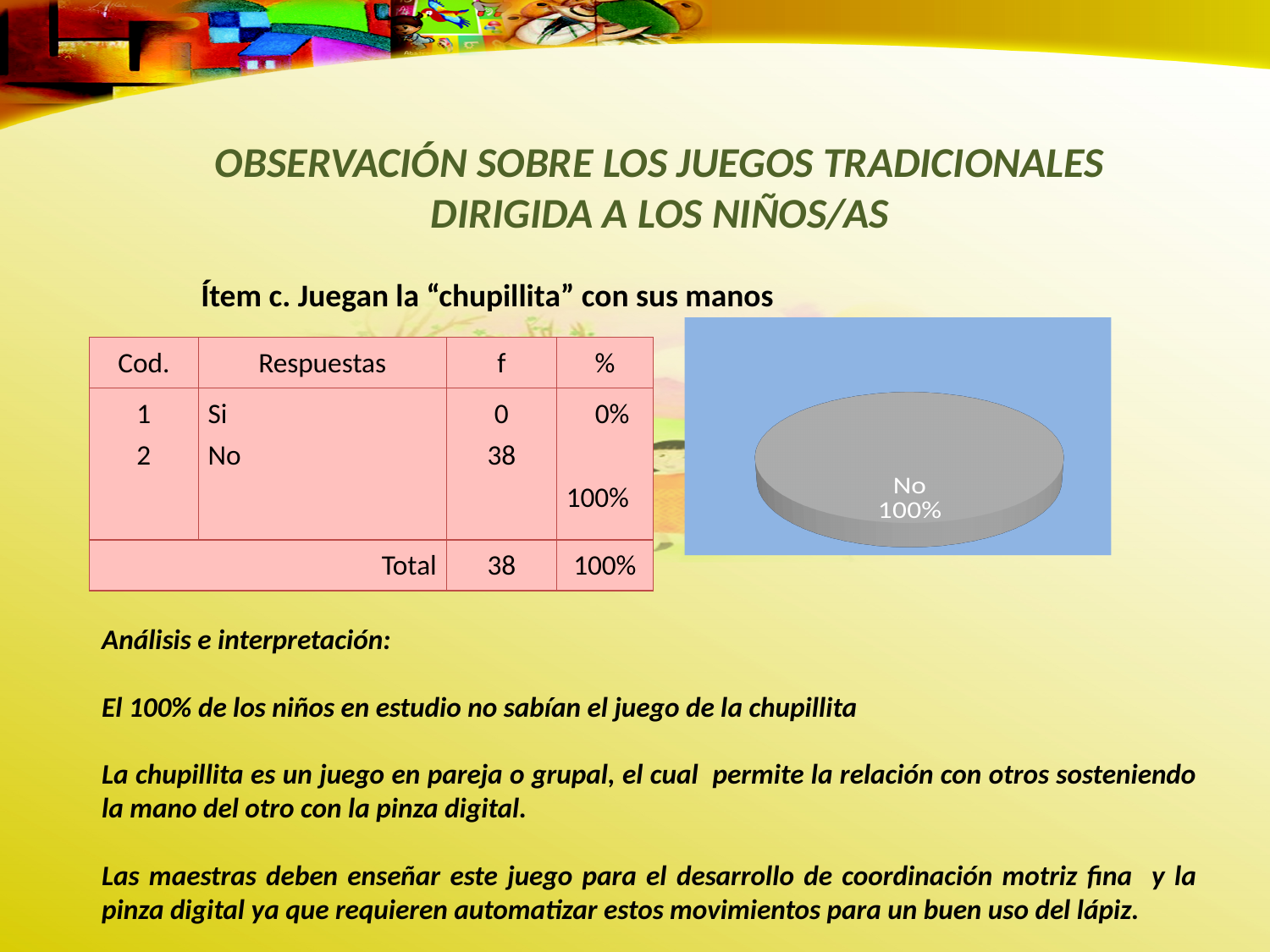
How many slices are visible in the pie chart? 1 What colour is the slice in the pie chart? grey What label is printed on the pie chart's slice? No 100% What share of the pie chart does the "No" slice represent? 100% What is the background colour of the pie chart area? blue Is the share of the "No" slice in the pie chart greater or less than 50%? greater Which category occupies the largest slice of the pie chart? No What kind of chart is shown on the slide? pie chart